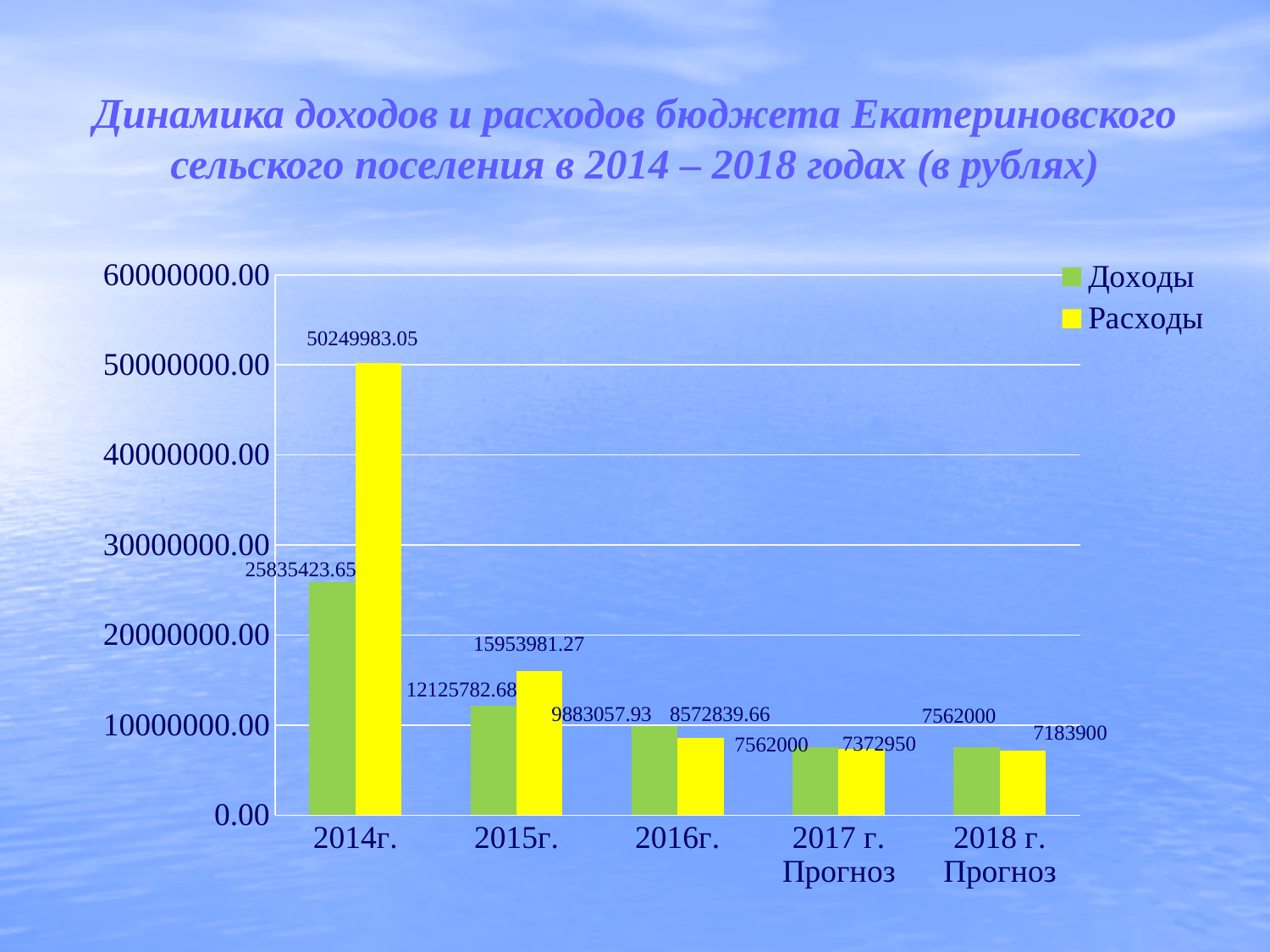
What is the difference between Расходы and Доходы in 2014г.? 24414559.40 Which is larger in 2016г., Доходы or Расходы? Доходы How many series does the legend list? 2 What is the value of Доходы for 2015г.? 12125782.68 What is the difference between Доходы and Расходы in 2017 г. Прогноз? 189050 In which category is Расходы lowest? 2018 г. Прогноз What is the value of Расходы for 2018 г. Прогноз? 7183900 What type of chart is shown on the slide? Bar chart How many categories are shown on the x axis? 5 In which year is Расходы highest? 2014г. What is the value of Расходы for 2014г.? 50249983.05 Do the Расходы values rise or fall from 2014г. to 2018 г. Прогноз? Fall